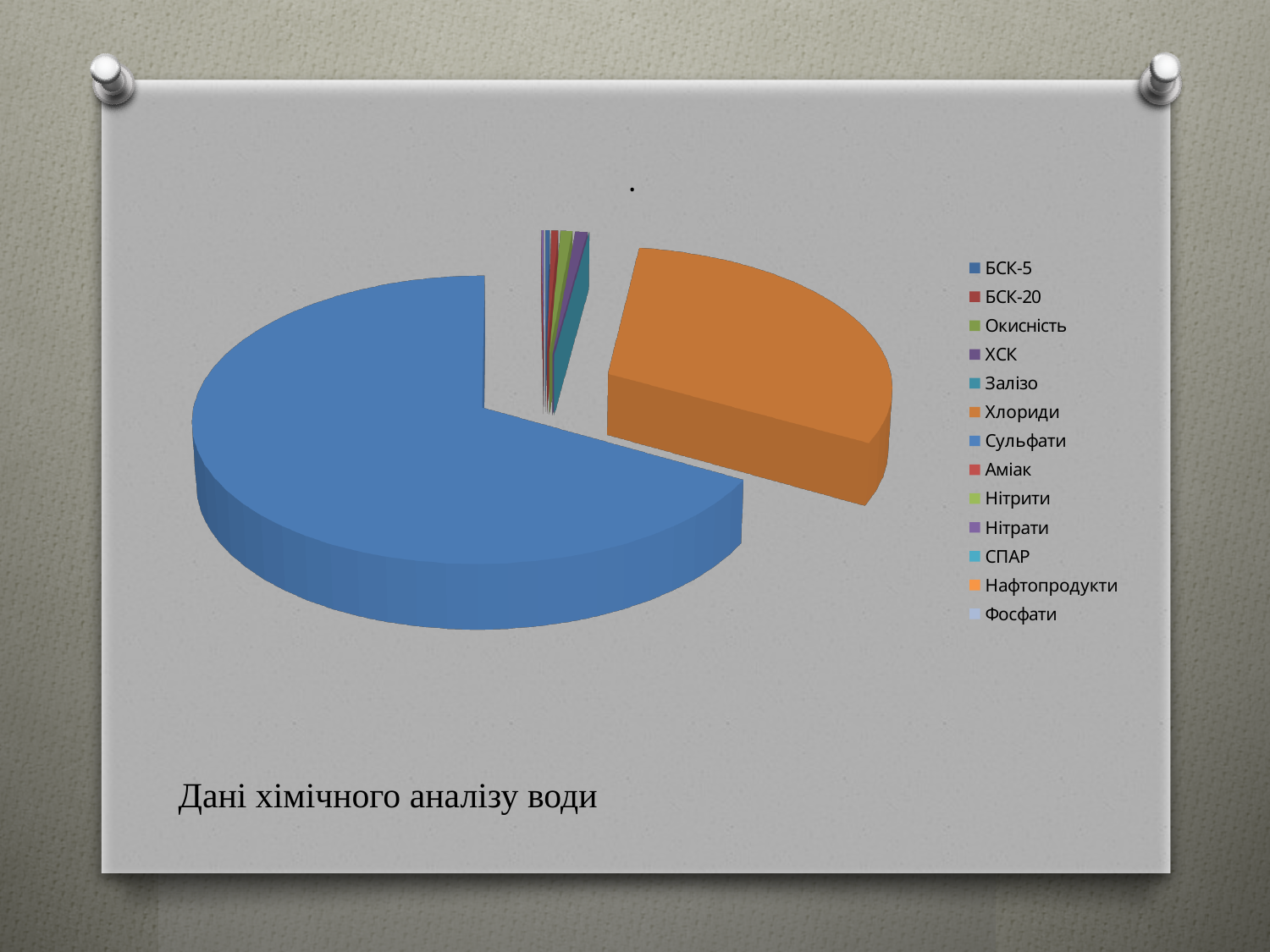
What is the first category listed in the legend of the pie chart? БСК-5 Which is larger in the pie chart, the slice for Хлориди or the slice for Сульфати? Сульфати How many categories does the legend of the pie chart list? 13 Which is larger in the pie chart, the slice for Хлориди or the slice for Залізо? Хлориди Which is larger in the pie chart, the slice for Сульфати or the slice for БСК-20? Сульфати What kind of chart is shown on the slide? pie chart Which category has the largest slice in the pie chart? Сульфати What colour is the slice for Хлориди in the pie chart? orange What is the caption text shown below the pie chart? Дані хімічного аналізу води